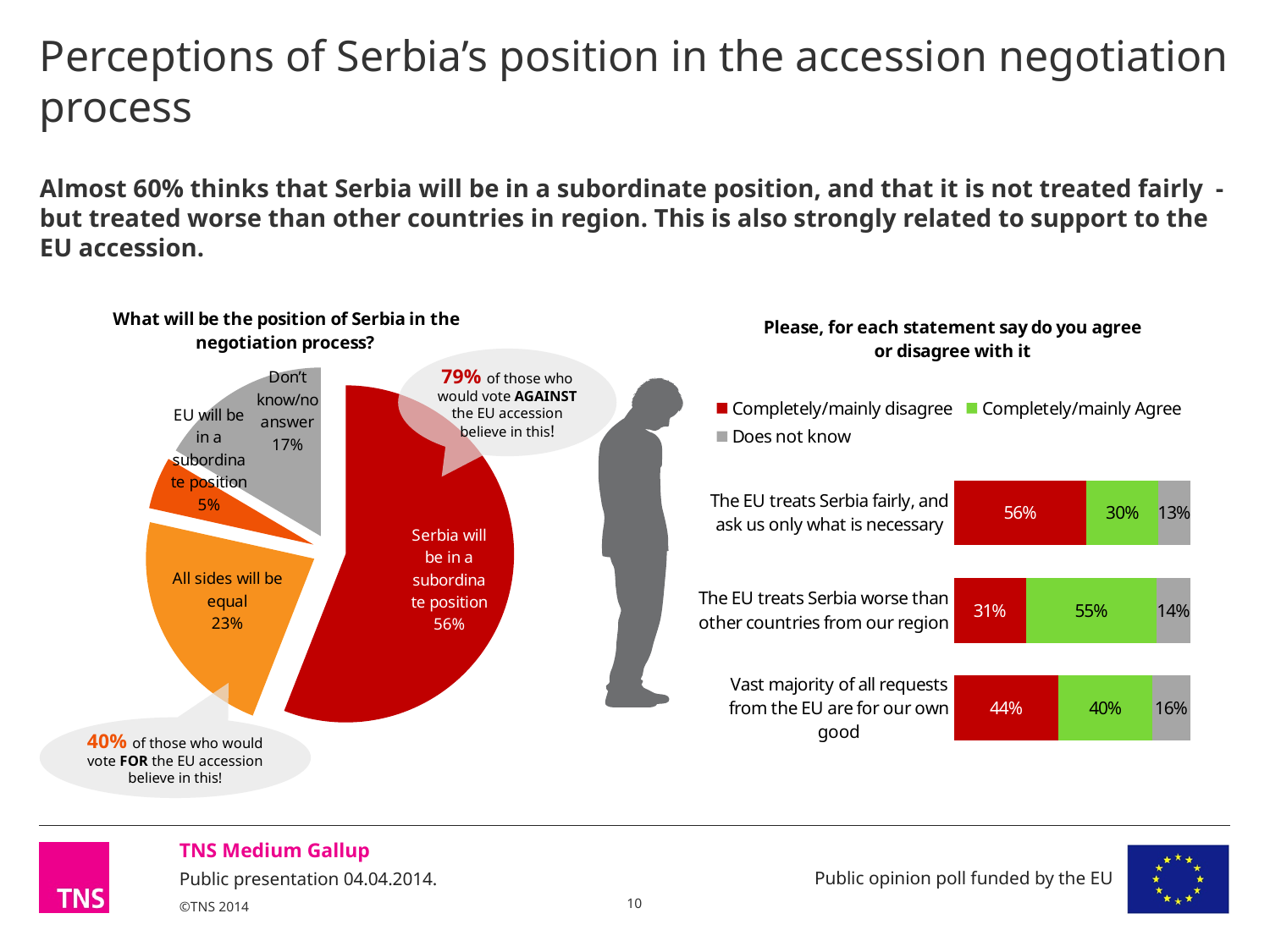
In the pie chart 'What will be the position of Serbia in the negotiation process?', how many slices are there? 4 In the pie chart 'What will be the position of Serbia in the negotiation process?', which is larger: 'Don't know/no answer' or 'EU will be in a subordinate position'? Don't know/no answer In the chart 'Please, for each statement say do you agree or disagree with it', what percentage completely/mainly agree that the EU treats Serbia worse than other countries from our region? 55% In the pie chart 'What will be the position of Serbia in the negotiation process?', what share of respondents said all sides will be equal? 23% In the pie chart 'What will be the position of Serbia in the negotiation process?', what share of respondents said Serbia will be in a subordinate position? 56% In the chart 'Please, for each statement say do you agree or disagree with it', what percentage completely/mainly disagree that the EU treats Serbia fairly and asks only what is necessary? 56% In the pie chart 'What will be the position of Serbia in the negotiation process?', which response has the smallest slice? EU will be in a subordinate position In the chart 'Please, for each statement say do you agree or disagree with it', which statement has the highest 'Completely/mainly Agree' share? The EU treats Serbia worse than other countries from our region What type of chart is shown on the right side of the slide under 'Please, for each statement say do you agree or disagree with it'? Stacked bar chart In the chart 'Please, for each statement say do you agree or disagree with it', how many series does the legend list? 3 In the chart 'Please, for each statement say do you agree or disagree with it', what percentage answered 'Does not know' for the statement 'Vast majority of all requests from the EU are for our own good'? 16% In the pie chart 'What will be the position of Serbia in the negotiation process?', what is the difference between the 'Serbia will be in a subordinate position' slice and the 'All sides will be equal' slice? 33 percentage points